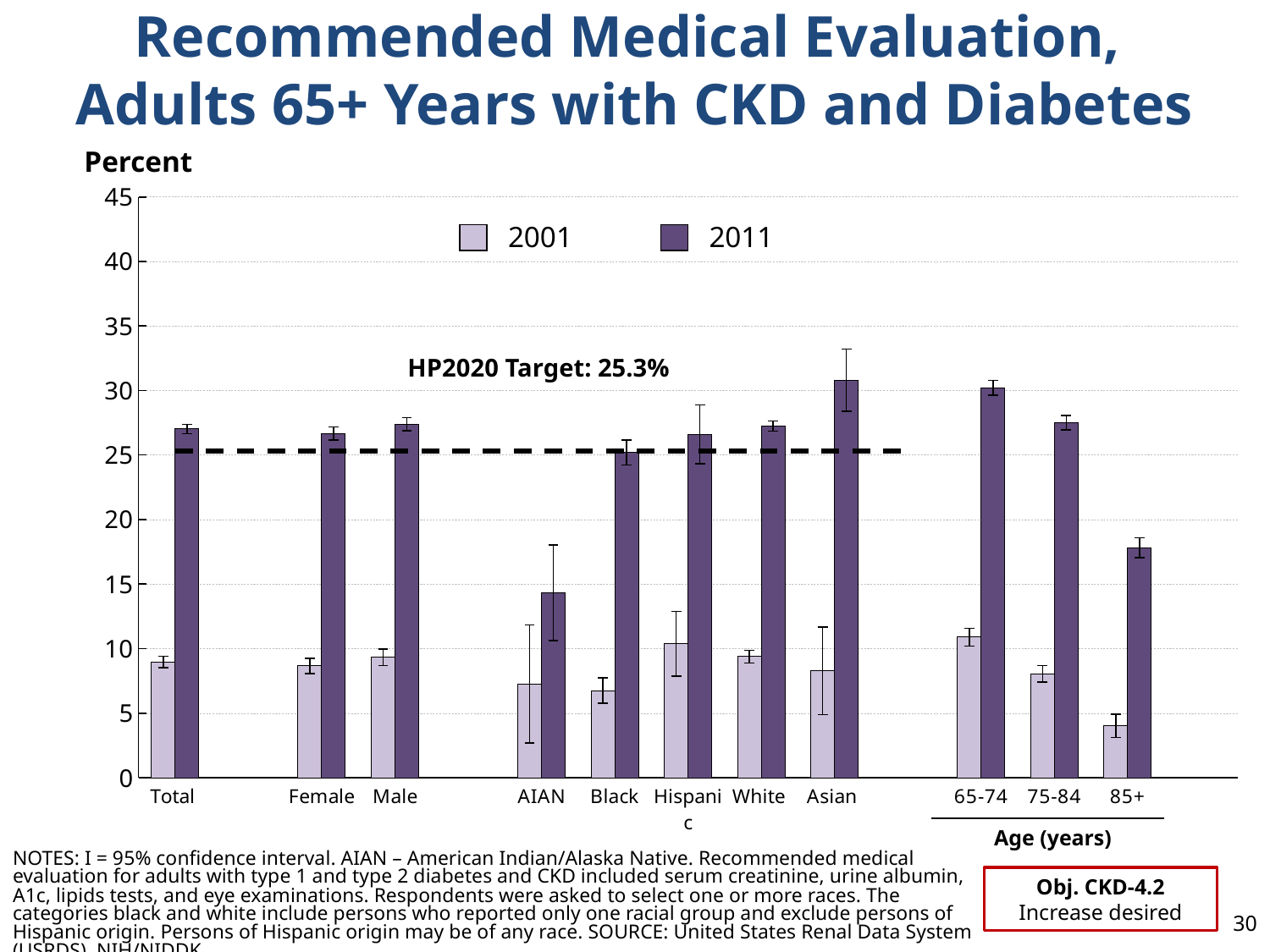
Is the 2011 value for Total greater or less than 25? greater What kind of chart is shown on the slide? bar chart Which category has the lowest 2011 value? AIAN Is the 2001 value for Total greater or less than 10? less Across the age groups 65-74, 75-84 and 85+, do the 2011 values rise or fall? fall Is the 2011 value for AIAN greater or less than 20? less How many series does the legend list? 2 How many categories are shown along the x axis? 11 Which is larger for the 65-74 age group, the 2001 value or the 2011 value? 2011 Which two years are shown in the legend? 2001 and 2011 What is the HP2020 Target value shown on the chart? 25.3% Which category has the lowest 2001 value? 85+